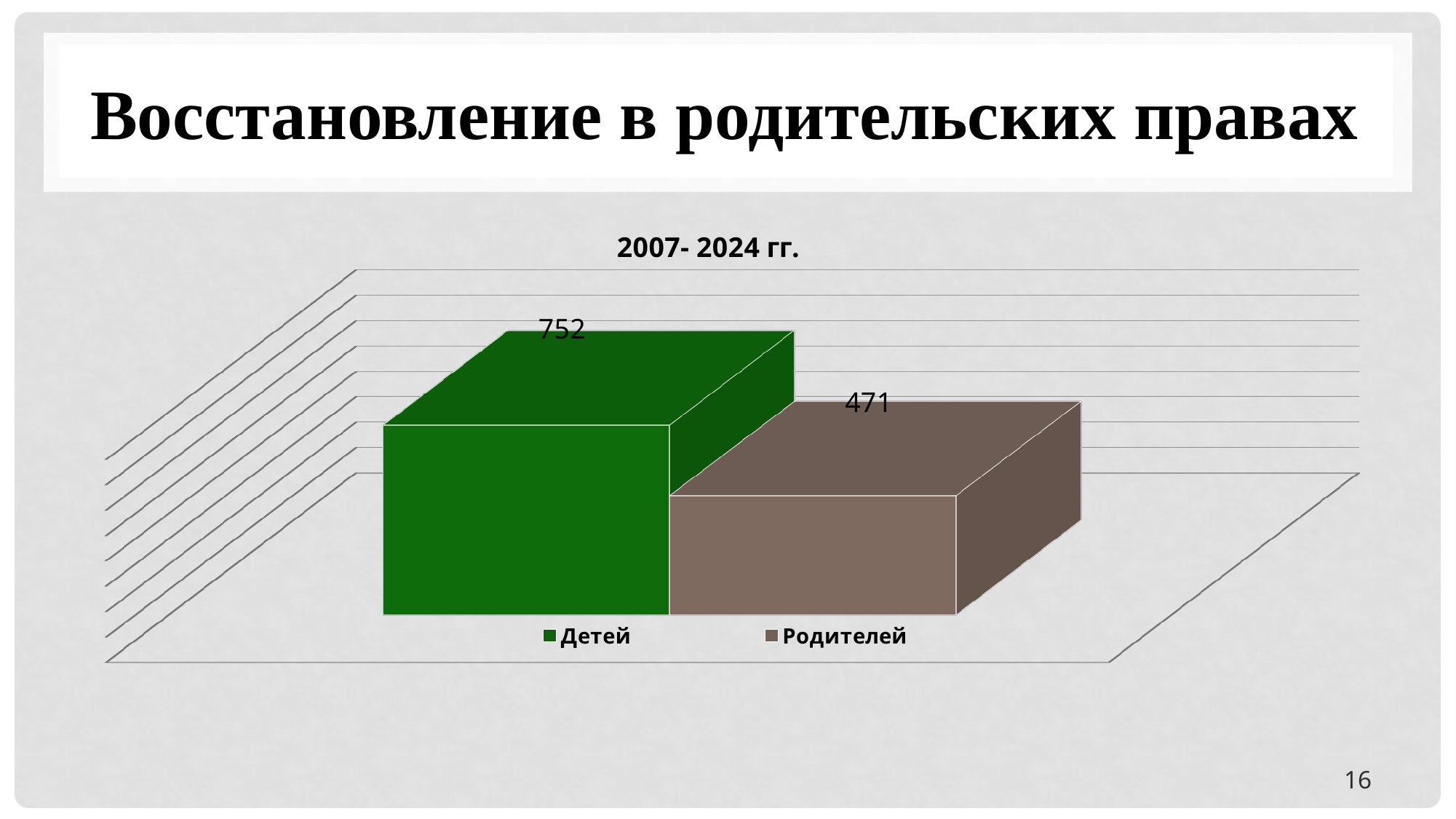
What is the value for Родителей? 471 Which series has the lowest value? Родителей What is the value for Детей? 752 How many bars are plotted on the chart? 2 How many series does the legend list? 2 Which is larger, the value for Детей or the value for Родителей? Детей What kind of chart is shown on the slide? bar chart What colour is the bar for Детей? green What is the title of the chart? 2007- 2024 гг. Which series has the highest value? Детей What is the difference between the values for Детей and Родителей? 281